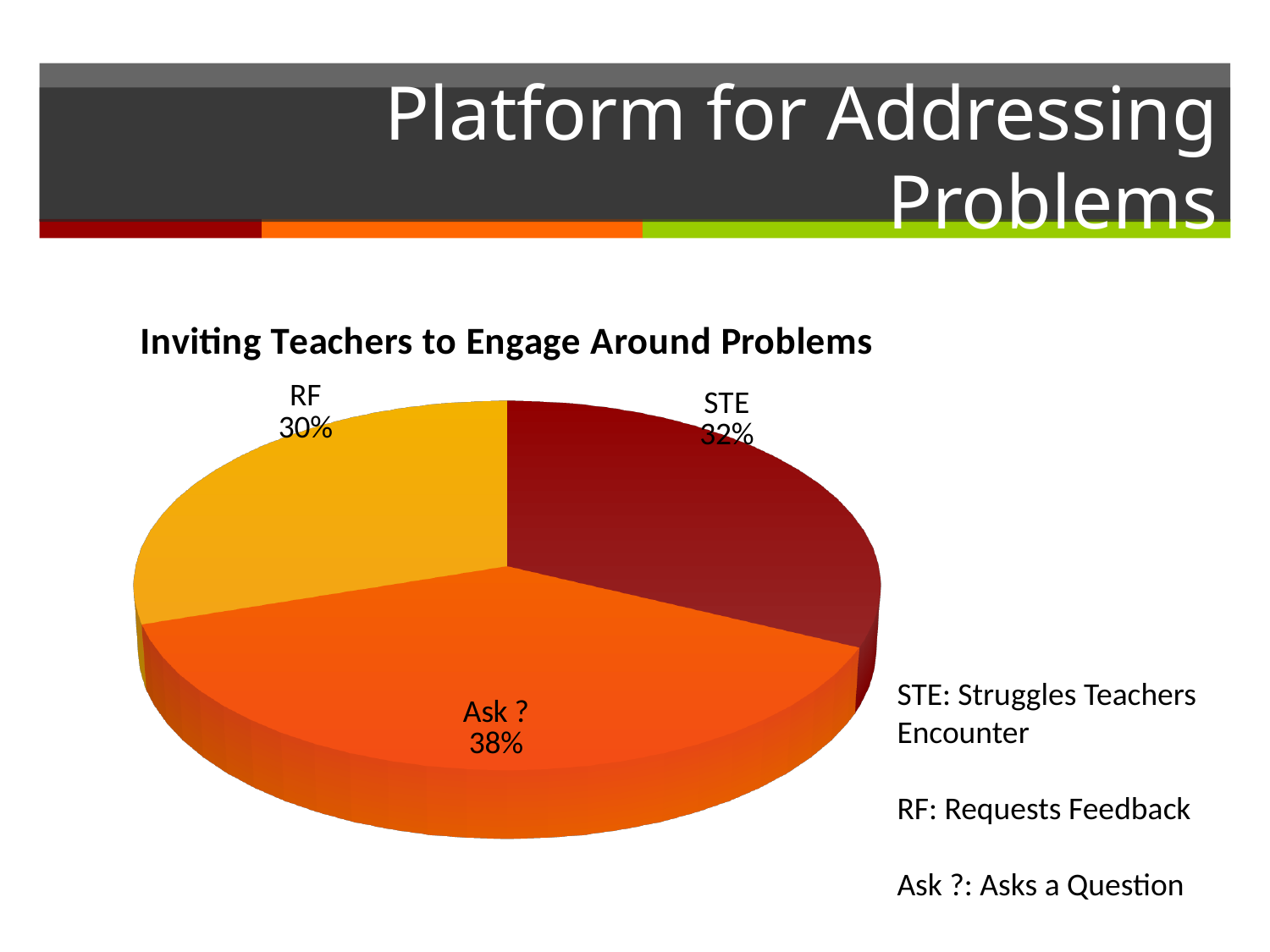
What is the title of the chart? Inviting Teachers to Engage Around Problems According to the key on the slide, what does STE stand for? Struggles Teachers Encounter What is the difference in percentage points between the Ask ? slice and the STE slice? 6 How many slices does the pie chart have? 3 What percentage is shown for the RF slice? 30% What is the difference in percentage points between the Ask ? slice and the RF slice? 8 What percentage is shown for the Ask ? slice? 38% Which category has the smallest share of the pie? RF Which is larger, the share for STE or the share for RF? STE What percentage is shown for the STE slice? 32% Which category has the largest share of the pie? Ask ? What kind of chart is shown on the slide? pie chart